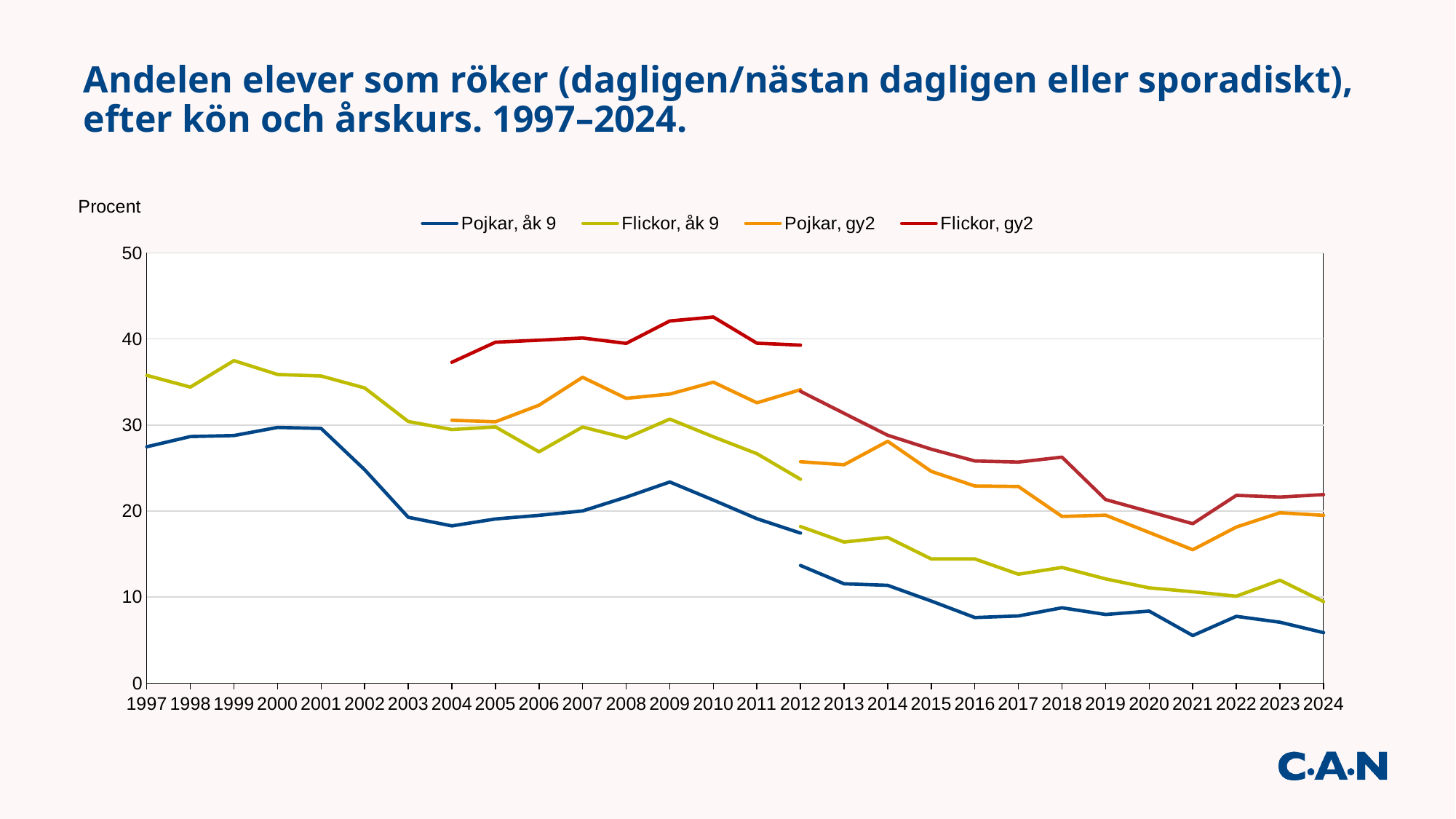
What is the label on the y axis? Procent Which series has the lowest value in 2024? Pojkar, åk 9 Does the value for Pojkar, åk 9 rise or fall from 1997 to 2024? fall Is the value for Flickor, åk 9 in 1999 greater or less than 30? greater In 2010, which is higher: Flickor, gy2 or Pojkar, gy2? Flickor, gy2 Does the value for Flickor, gy2 rise or fall from 2004 to 2010? rise What kind of chart is shown on the slide? line chart Is the value for Pojkar, åk 9 in 2021 greater or less than 10? less How many years are labelled on the x axis? 28 What are the four series named in the legend? Pojkar, åk 9; Flickor, åk 9; Pojkar, gy2; Flickor, gy2 Is the value for Flickor, gy2 in 2010 greater or less than 40? greater How many series does the legend list? 4